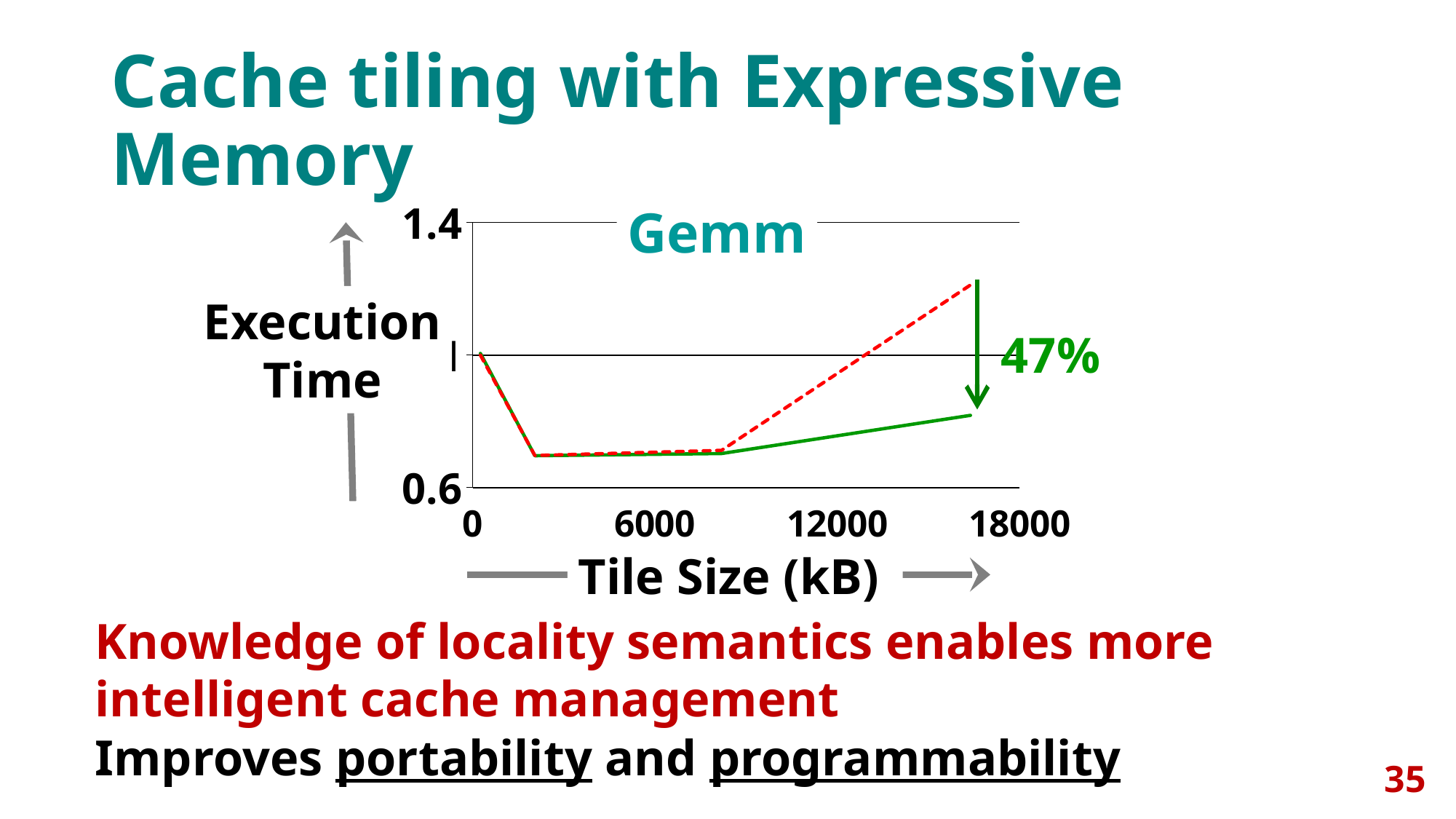
What is the title of the chart? Gemm What is the largest tile size shown on the x axis of the chart? 18000 Between tile sizes of 6000 and 18000, does the red dashed line rise or fall? rise What is the label of the x axis of the chart? Tile Size (kB) At the largest tile size plotted, is the execution time of the red dashed line greater or less than 1.0? greater At the largest tile size plotted, which line has the higher execution time, the red dashed line or the green solid line? red dashed line What kind of chart is shown on the slide? line chart What percentage reduction is annotated next to the green arrow in the chart? 47% How many lines are plotted in the chart? 2 What is the highest value shown on the y axis of the chart? 1.4 What is the lowest value shown on the y axis of the chart? 0.6 At the largest tile size plotted, is the execution time of the green solid line greater or less than 1.0? less